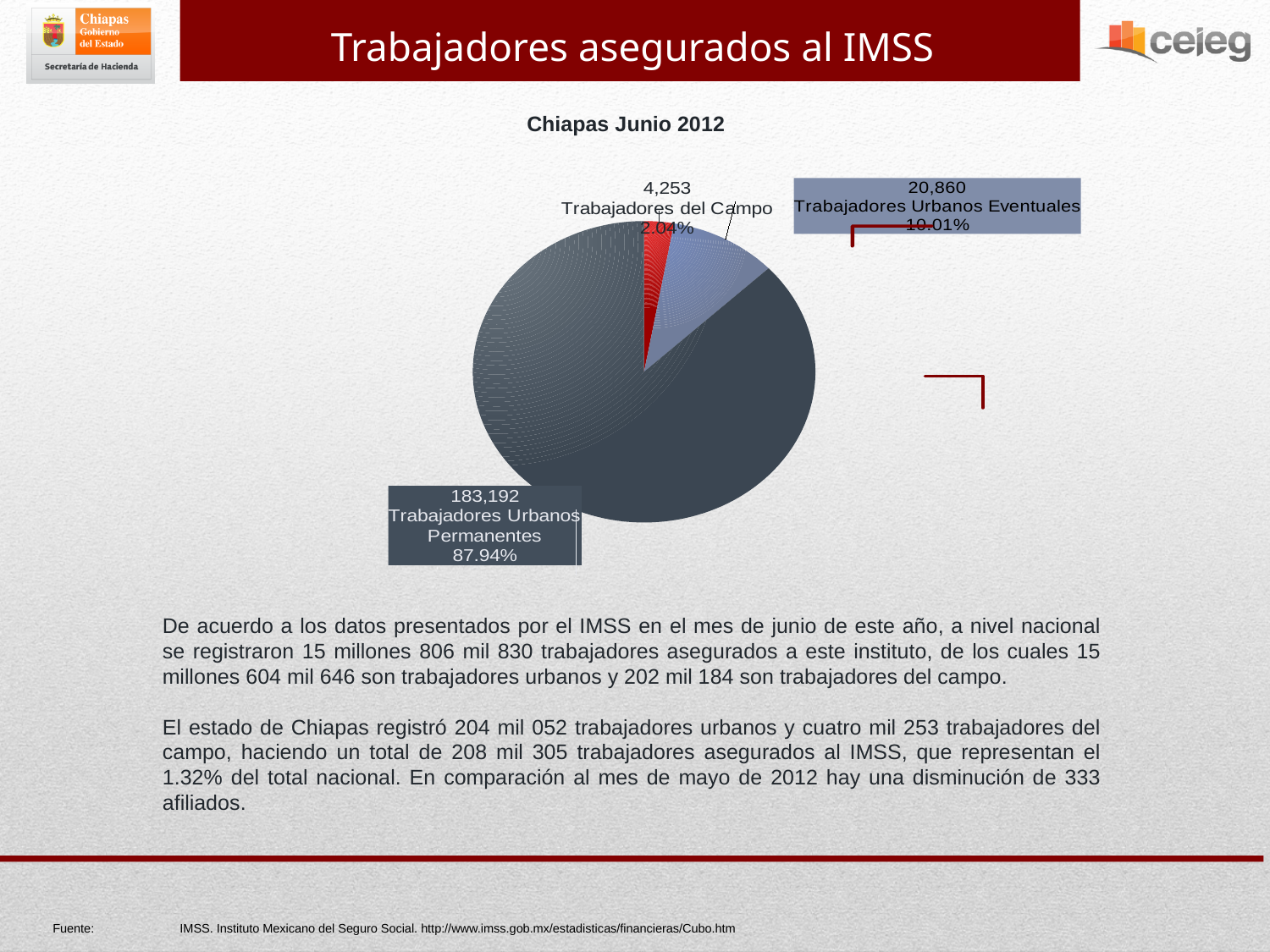
What is the difference between the values for Trabajadores Urbanos Eventuales and Trabajadores del Campo? 16,607 Which category has the smallest slice of the pie? Trabajadores del Campo Which is larger, the value for Trabajadores Urbanos Eventuales or Trabajadores del Campo? Trabajadores Urbanos Eventuales What share of the pie does Trabajadores del Campo represent? 2.04% What is the title of the chart? Chiapas Junio 2012 What is the value for Trabajadores Urbanos Eventuales? 20,860 What is the value for Trabajadores Urbanos Permanentes? 183,192 Which category has the largest slice of the pie? Trabajadores Urbanos Permanentes What is the value for Trabajadores del Campo? 4,253 How many slices does the pie chart have? 3 What share of the pie does Trabajadores Urbanos Eventuales represent? 10.01% What type of chart is shown on the slide? Pie chart